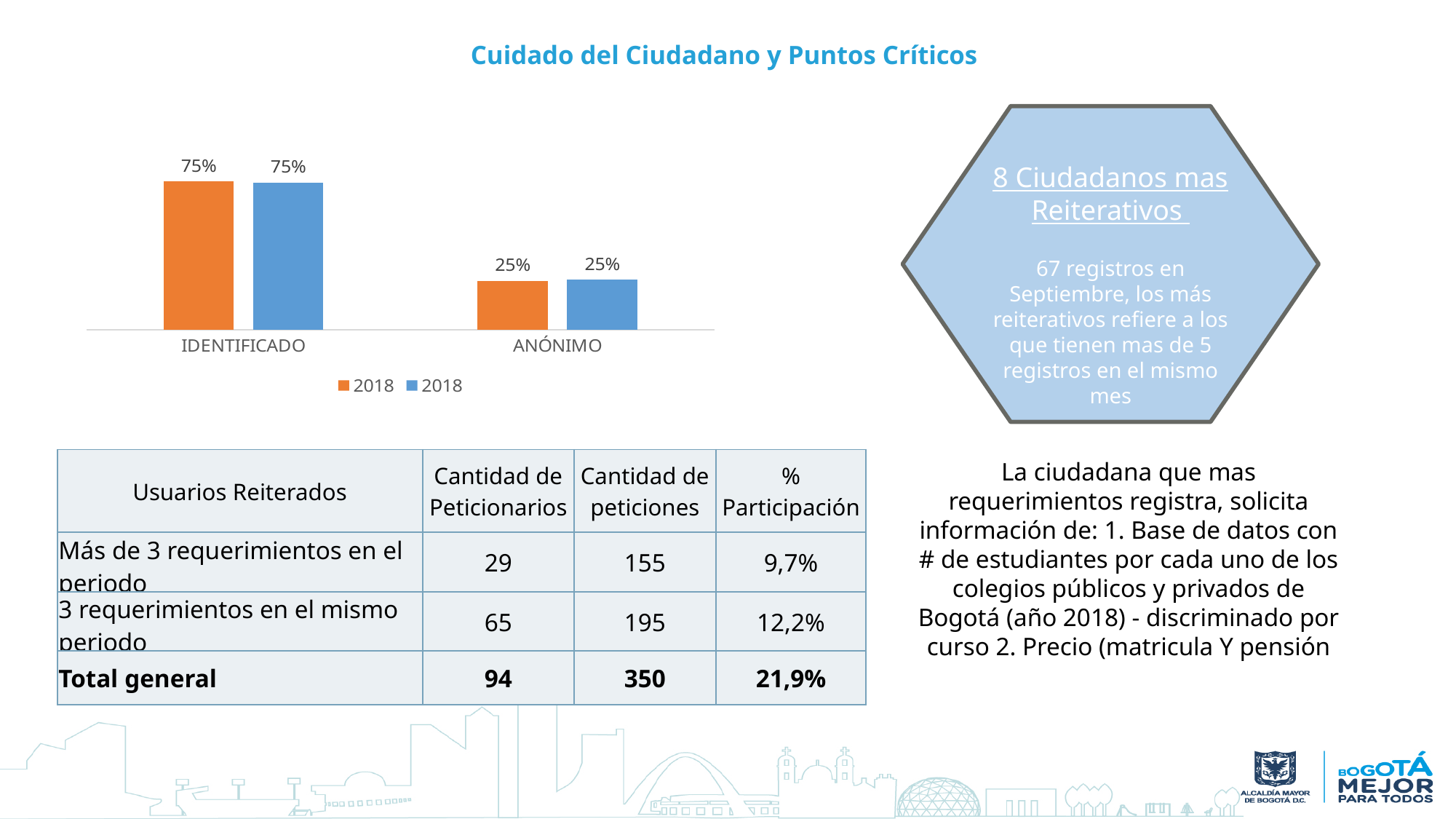
How many series does the legend of the bar chart list? 2 What is the value of the blue bar for ANÓNIMO? 25% What type of chart is shown on the slide? bar chart What is the difference between the orange bar for IDENTIFICADO and the orange bar for ANÓNIMO? 50% Which category has the highest values in the bar chart? IDENTIFICADO Which is larger: the blue bar for IDENTIFICADO or the blue bar for ANÓNIMO? IDENTIFICADO What is the value of the orange bar for IDENTIFICADO? 75% What colour is the first series in the chart legend? orange How many categories are shown on the x axis of the bar chart? 2 What is the value of the orange bar for ANÓNIMO? 25% What label is shown for both entries in the chart legend? 2018 Which category has the lowest values in the bar chart? ANÓNIMO